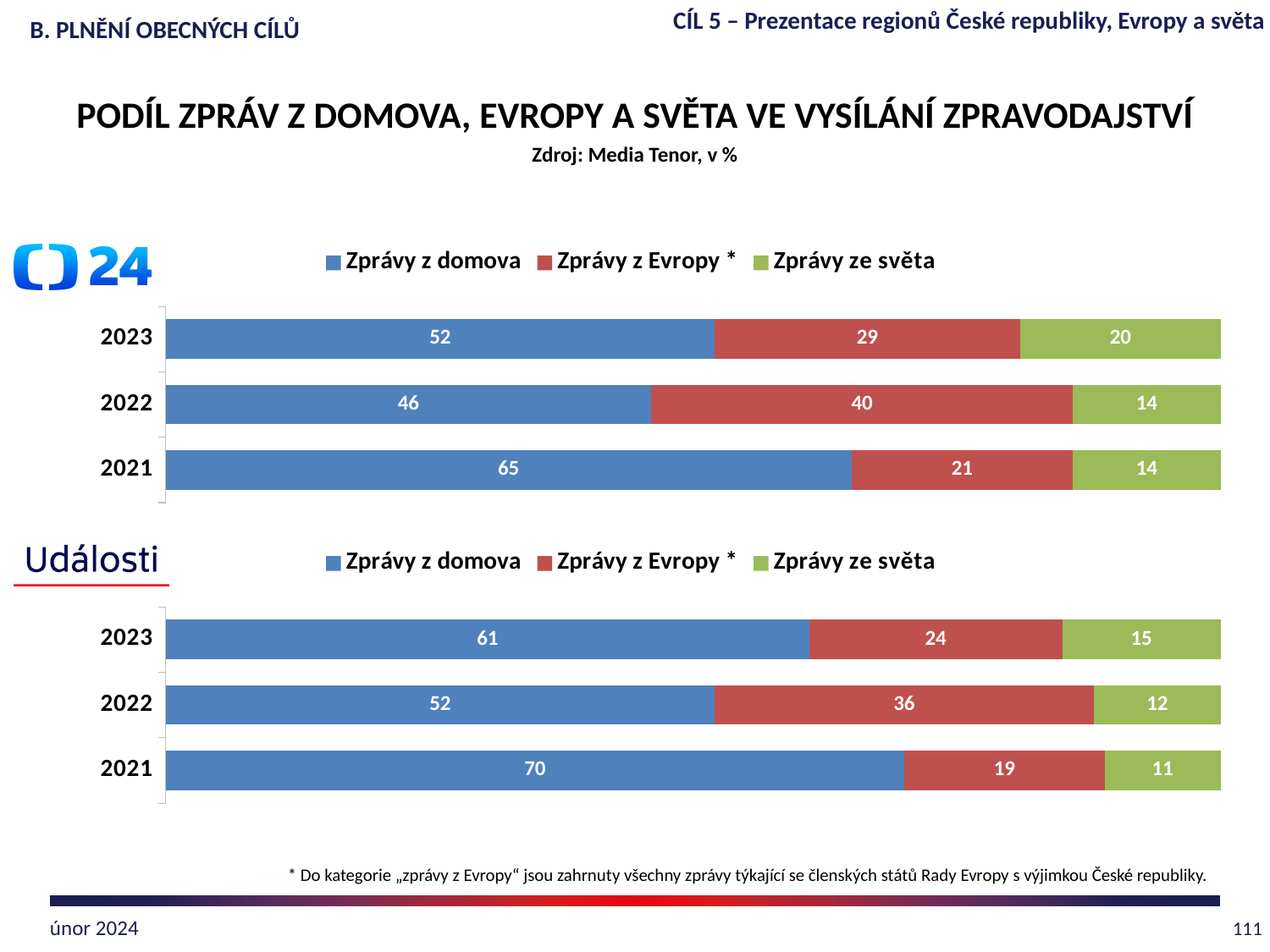
In the bottom chart (Události), which is larger: Zprávy z Evropy in 2022 or Zprávy z Evropy in 2023? Zprávy z Evropy in 2022 What kind of chart is the top chart (ČT24)? Stacked bar chart In the bottom chart (Události), what is the value for Zprávy ze světa in 2021? 11 In the top chart (ČT24), which year has the highest value for Zprávy z domova? 2021 In the top chart (ČT24), what is the difference between the Zprávy z domova values for 2021 and 2022? 19 In the bottom chart (Události), what is the total of the stacked bar for 2021? 100 In the bottom chart (Události), what is the value for Zprávy z domova in 2022? 52 How many series does the legend of the top chart (ČT24) list? 3 In the top chart (ČT24), what is the value for Zprávy z Evropy in 2022? 40 How many years are shown in the bottom chart (Události)? 3 In the bottom chart (Události), which year has the lowest value for Zprávy z Evropy? 2021 In the top chart (ČT24), what is the value for Zprávy z domova in 2023? 52